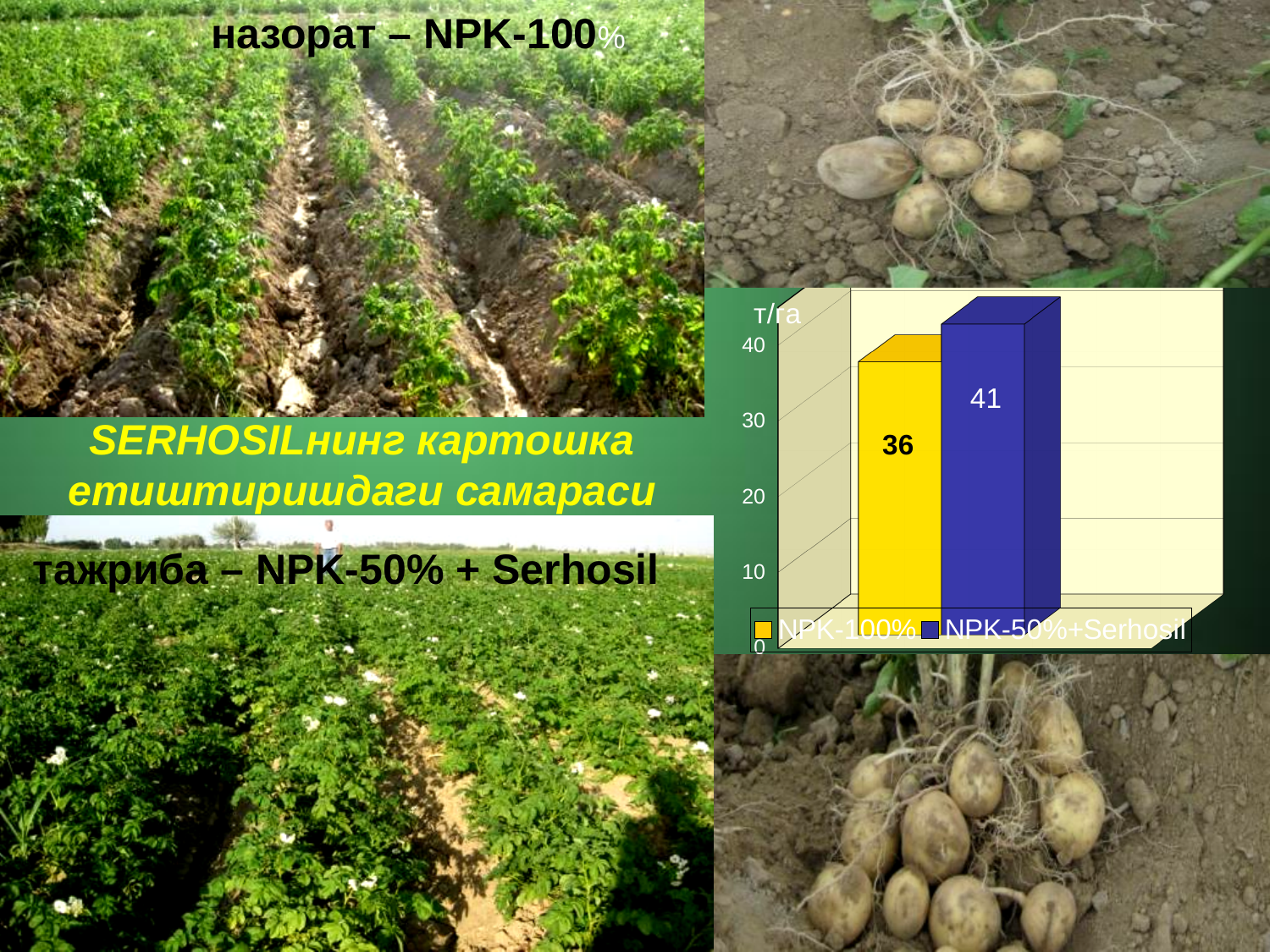
How many series does the chart legend list? 2 Which series has the lowest value in the chart? NPK-100% What is the difference between the values for NPK-50%+Serhosil and NPK-100%? 5 What is the value for NPK-50%+Serhosil in the chart? 41 How many bars are plotted in the chart? 2 Which series has the highest value in the chart? NPK-50%+Serhosil What kind of chart is shown on the slide? bar chart Is the value for NPK-100% greater or less than 40? less What unit is shown on the vertical axis of the chart? т/га Which is larger, the value for NPK-100% or the value for NPK-50%+Serhosil? NPK-50%+Serhosil Is the value for NPK-50%+Serhosil greater or less than 40? greater What is the value for NPK-100% in the chart? 36